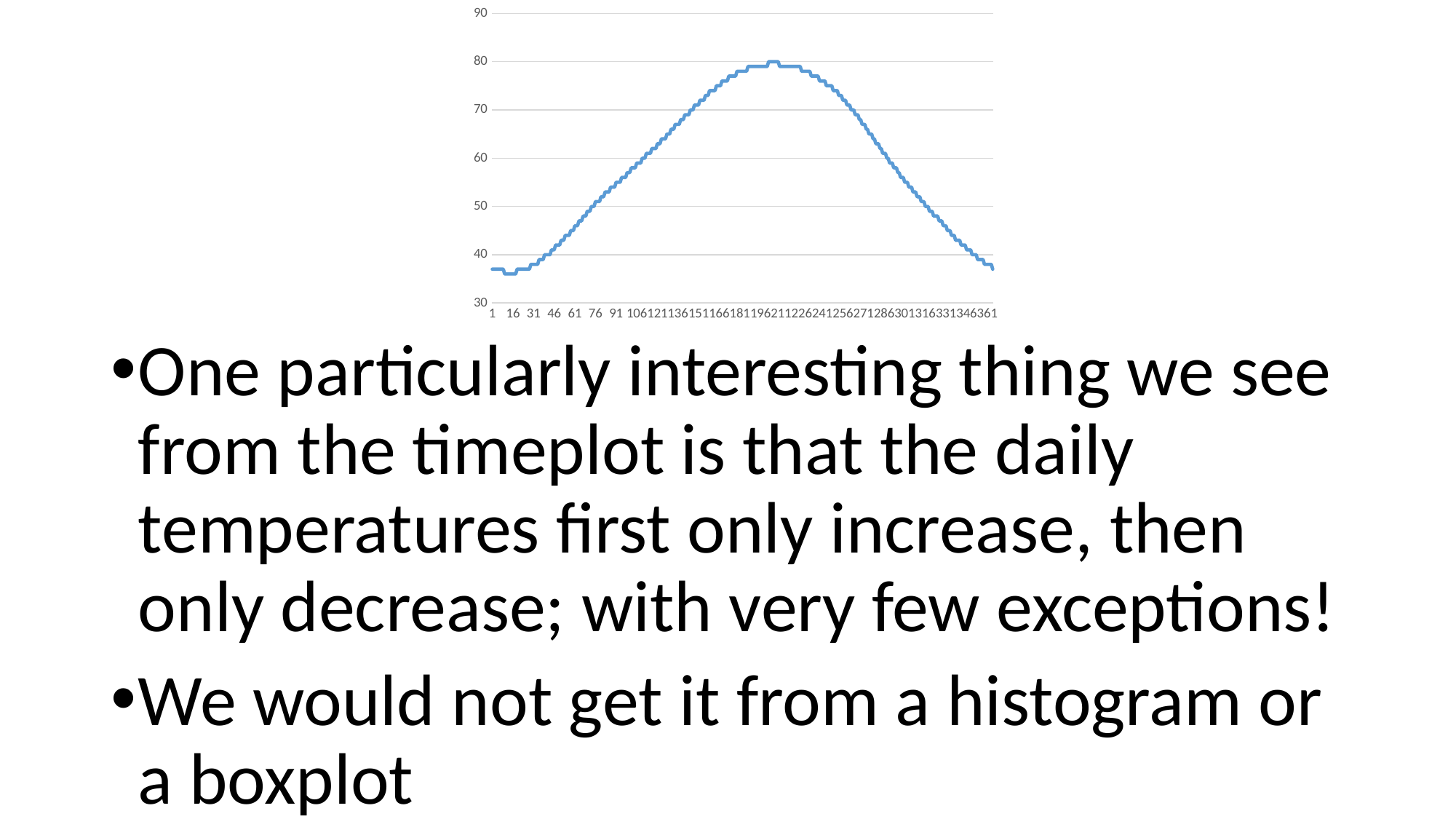
What kind of chart is shown on the slide? line chart Is the value at x = 331 greater or less than 50? less Is the highest point of the line greater or less than 70? greater Does the line rise or fall between x = 1 and x = 181? rise What is the lowest value shown on the y axis? 30 Does the line rise or fall between x = 211 and x = 361? fall Is the value at x = 361 greater or less than 40? less How many lines (data series) are plotted on the chart? 1 What is the last label shown on the x axis? 361 Which is larger, the value at x = 181 or the value at x = 361? x = 181